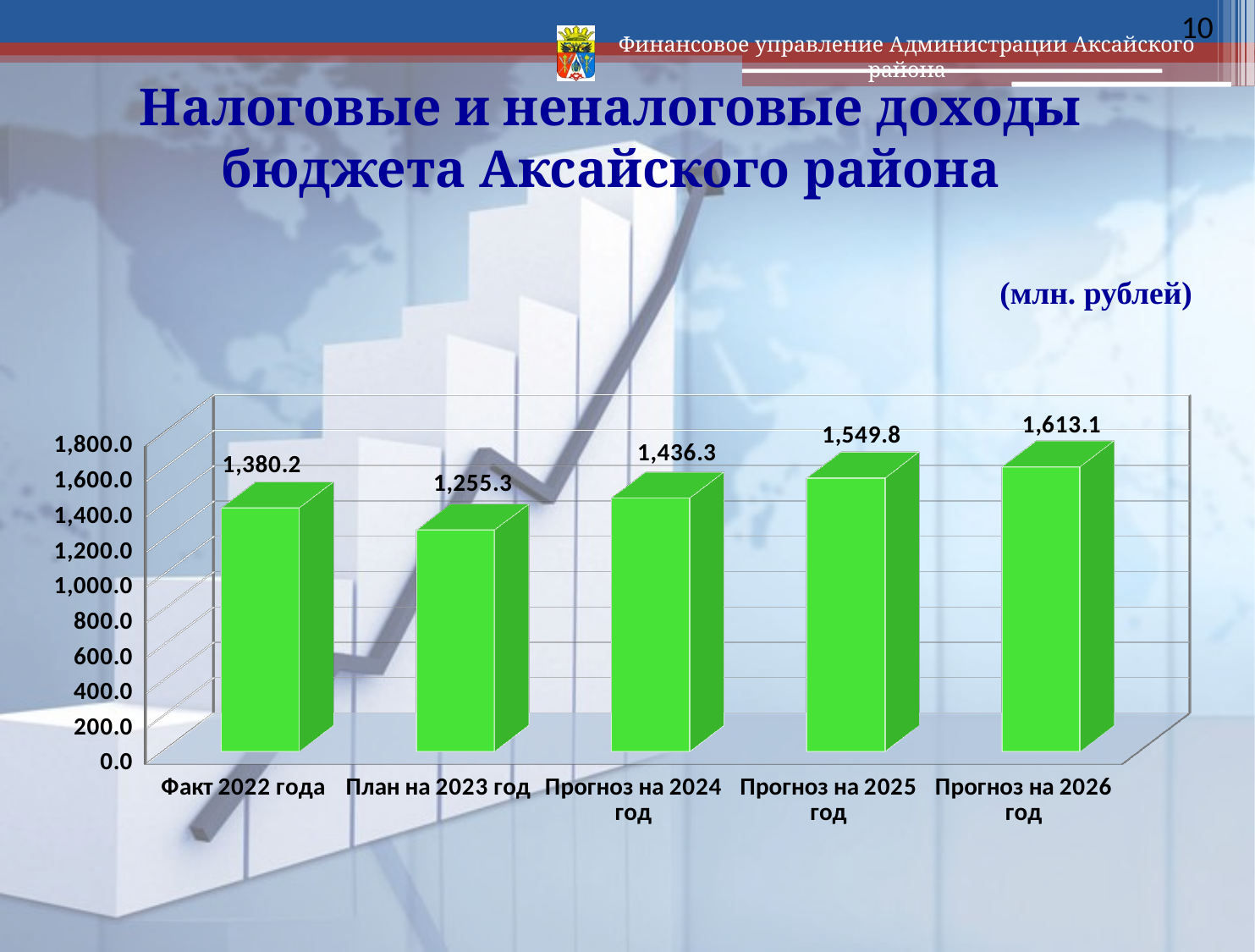
What is the value for План на 2023 год? 1,255.3 What is the difference between the values for Факт 2022 года and План на 2023 год? 124.9 Is the value for Прогноз на 2025 год greater or less than 1,400.0? greater Which category has the highest value? Прогноз на 2026 год Do the values rise or fall from План на 2023 год to Прогноз на 2026 год? rise What is the value for Прогноз на 2025 год? 1,549.8 Which is larger, the value for Факт 2022 года or the value for Прогноз на 2024 год? Прогноз на 2024 год What is the value for Факт 2022 года? 1,380.2 Which category has the lowest value? План на 2023 год What kind of chart is shown on the slide? bar chart What is the difference between the values for Прогноз на 2026 год and План на 2023 год? 357.8 How many categories are shown on the chart? 5